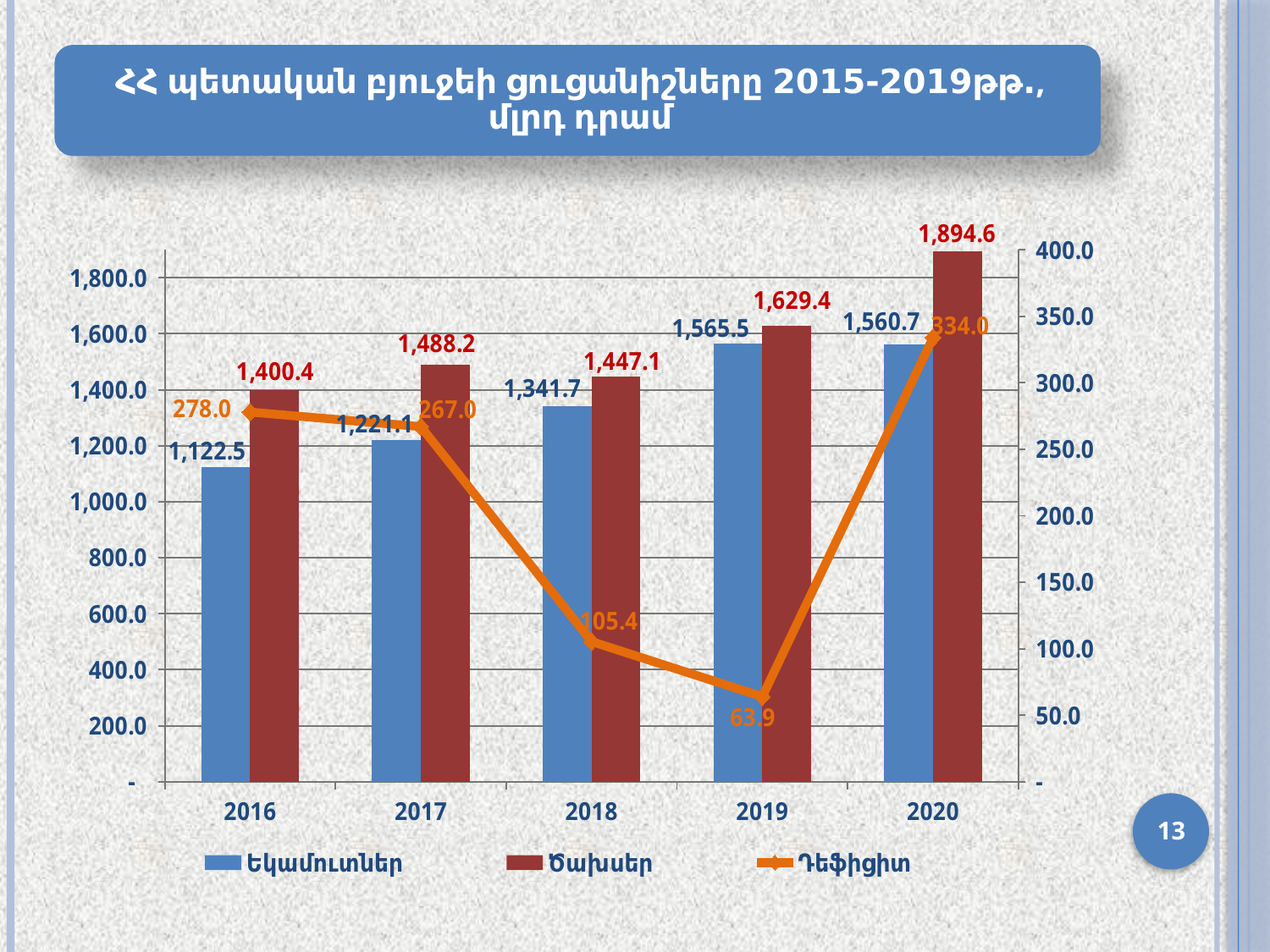
What kind of chart is this? Combined bar and line chart Which is larger in 2019, Եկամուտներ or Ծախսեր? Ծախսեր In which year is Ծախսեր highest? 2020 Does Ծախսեր rise or fall from 2016 to 2020? Rise How many years are shown on the x axis? 5 Which series is plotted as an orange line? Դեֆիցիտ How many series does the legend list? 3 What is the difference between Ծախսեր and Եկամուտներ in 2017? 267.1 What is the value of Եկամուտներ for 2016? 1,122.5 What is the value of Դեֆիցիտ for 2018? 105.4 What is the value of Ծախսեր for 2020? 1,894.6 In which year is Դեֆիցիտ lowest? 2019